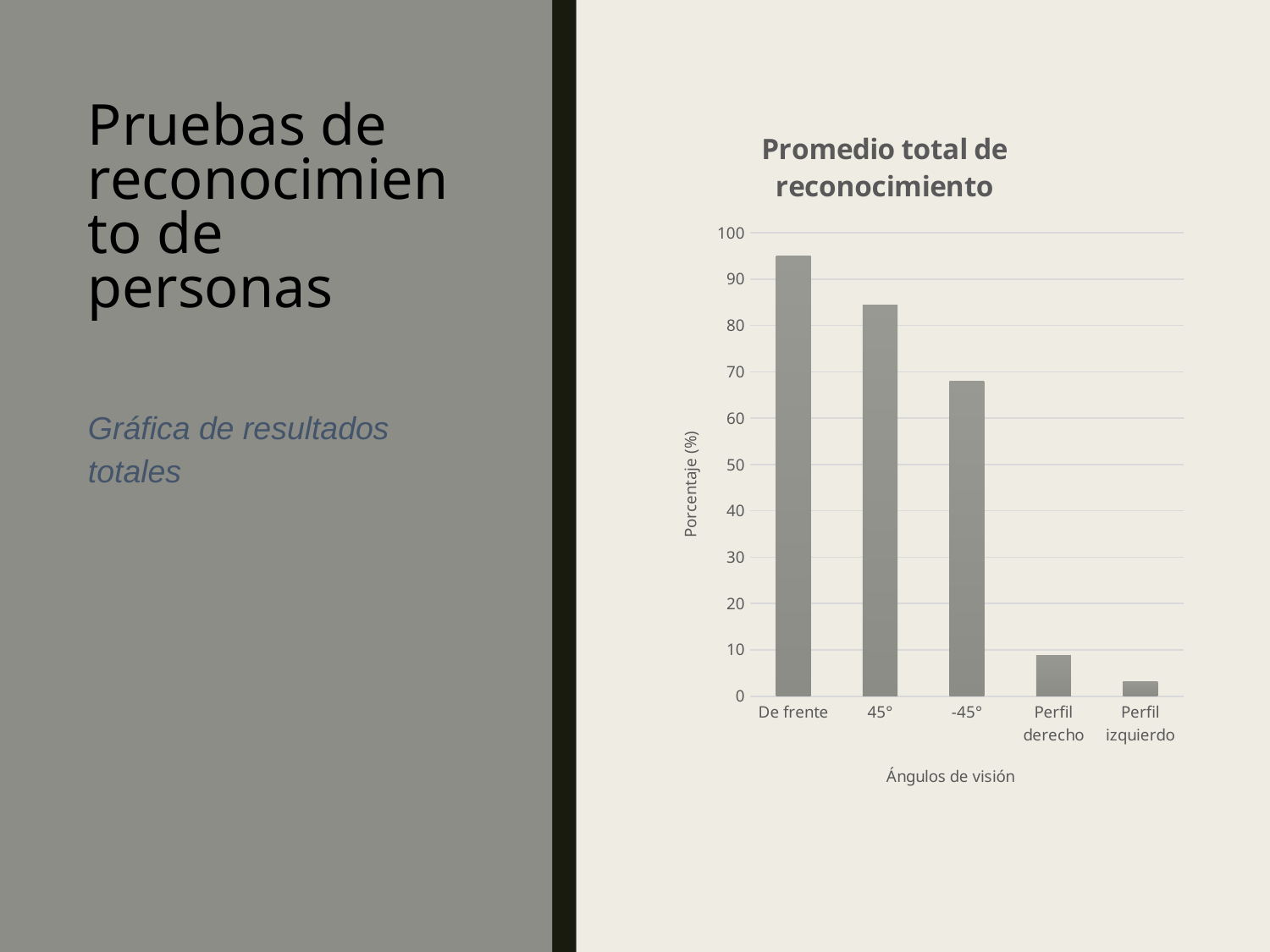
What kind of chart is shown on the slide? bar chart Is the value for -45° greater or less than 70? less Which is larger, the value for 45° or the value for -45°? 45° How many categories are shown on the x axis of the chart? 5 Which category has the lowest value in the chart? Perfil izquierdo Is the value for De frente greater or less than 90? greater Do the values rise or fall moving from left to right along the x axis? fall Is the value for 45° greater or less than 80? greater What is the title of the chart? Promedio total de reconocimiento Which category has the highest value in the chart? De frente What is the label of the y axis of the chart? Porcentaje (%)